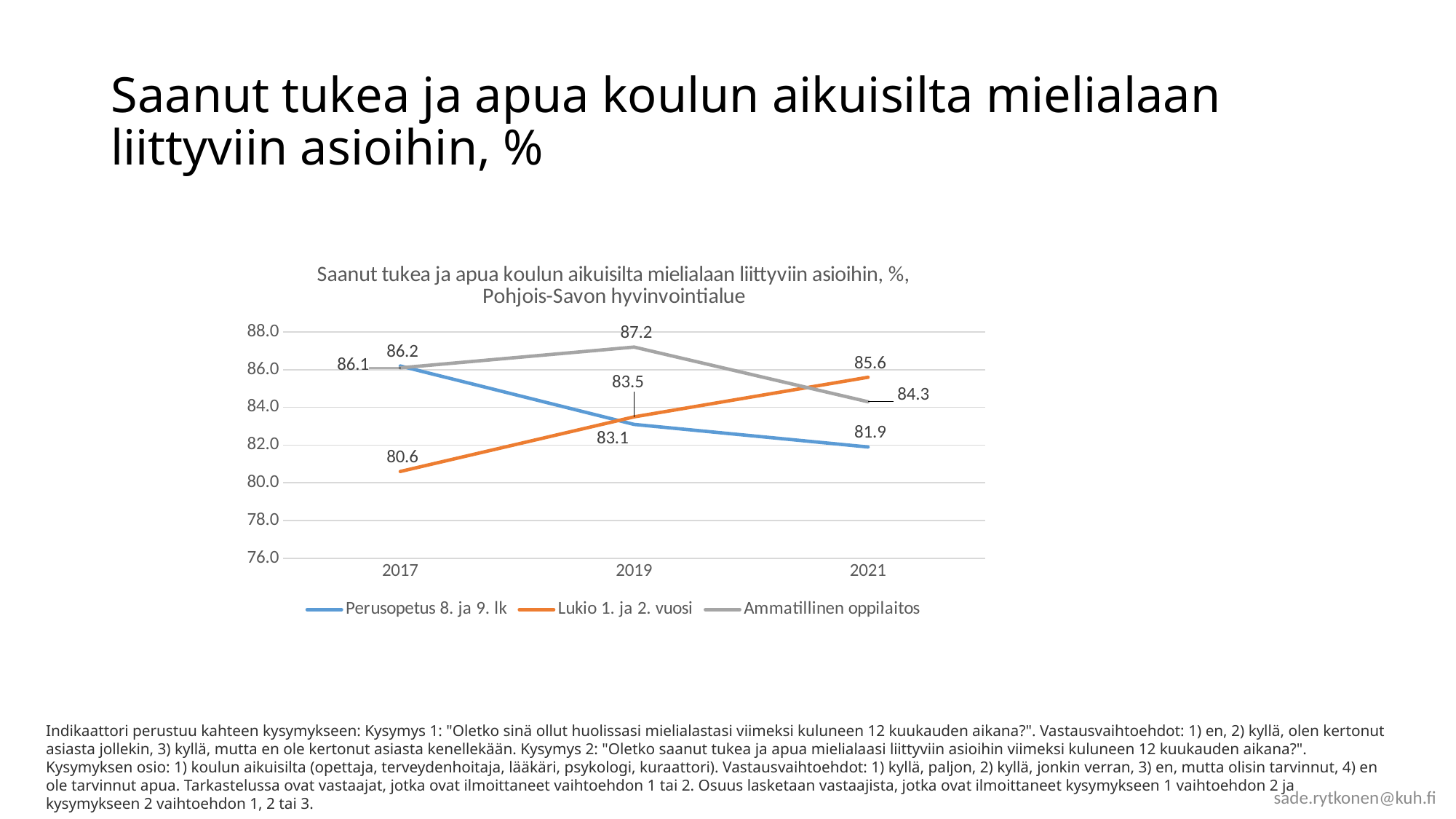
Which region is named in the chart title? Pohjois-Savon hyvinvointialue What is the value for Ammatillinen oppilaitos in 2019? 87.2 Does the Perusopetus 8. ja 9. lk line rise or fall from 2017 to 2021? fall How many series does the legend list? 3 How many years are shown on the x axis? 3 What is the difference between the Lukio 1. ja 2. vuosi values in 2021 and 2017? 5.0 Which series has the highest value in 2021? Lukio 1. ja 2. vuosi What is the value for Perusopetus 8. ja 9. lk in 2021? 81.9 Which series has the lowest value in 2017? Lukio 1. ja 2. vuosi Which is larger in 2019: Ammatillinen oppilaitos or Perusopetus 8. ja 9. lk? Ammatillinen oppilaitos What kind of chart is shown on the slide? line chart What is the value for Lukio 1. ja 2. vuosi in 2017? 80.6